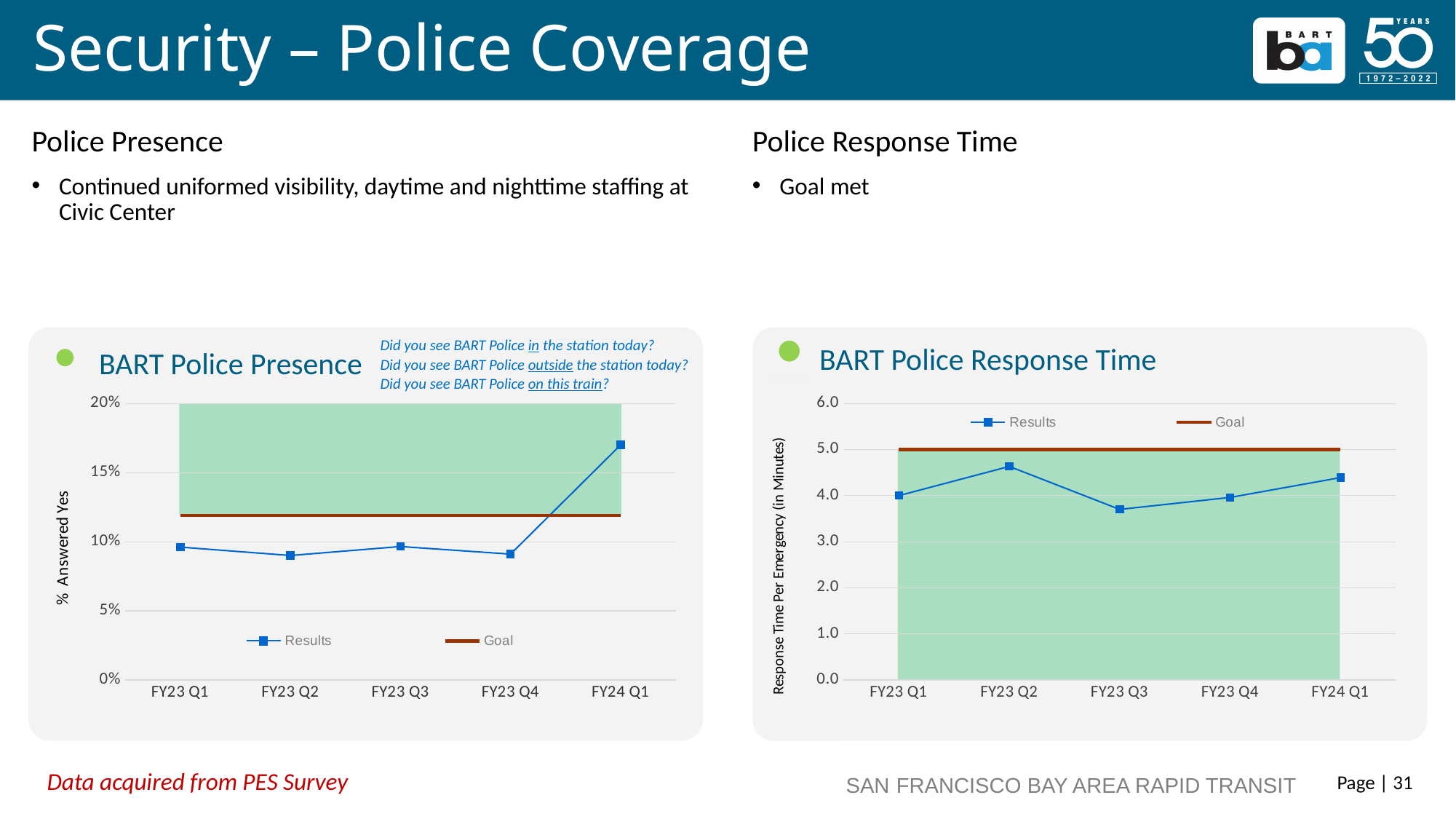
In the BART Police Response Time chart, which is larger, the Results value for FY23 Q2 or for FY23 Q3? FY23 Q2 In the BART Police Presence chart, does the Results line rise or fall between FY23 Q4 and FY24 Q1? rise In the BART Police Presence chart, is the Results value for FY24 Q1 greater or less than 15%? greater In the BART Police Response Time chart, which quarter has the lowest Results value? FY23 Q3 In the BART Police Response Time chart, is the Results value for FY23 Q3 greater or less than 4.0? less What is the y-axis label of the BART Police Response Time chart? Response Time Per Emergency (in Minutes) In the BART Police Presence chart, is the Results value for FY23 Q2 greater or less than 10%? less How many quarters are plotted on the x axis of the BART Police Presence chart? 5 How many series does the legend of the BART Police Presence chart list? 2 What type of chart is the BART Police Presence chart? line chart In the BART Police Presence chart, which quarter has the highest Results value? FY24 Q1 In the BART Police Response Time chart, which quarter has the highest Results value? FY23 Q2